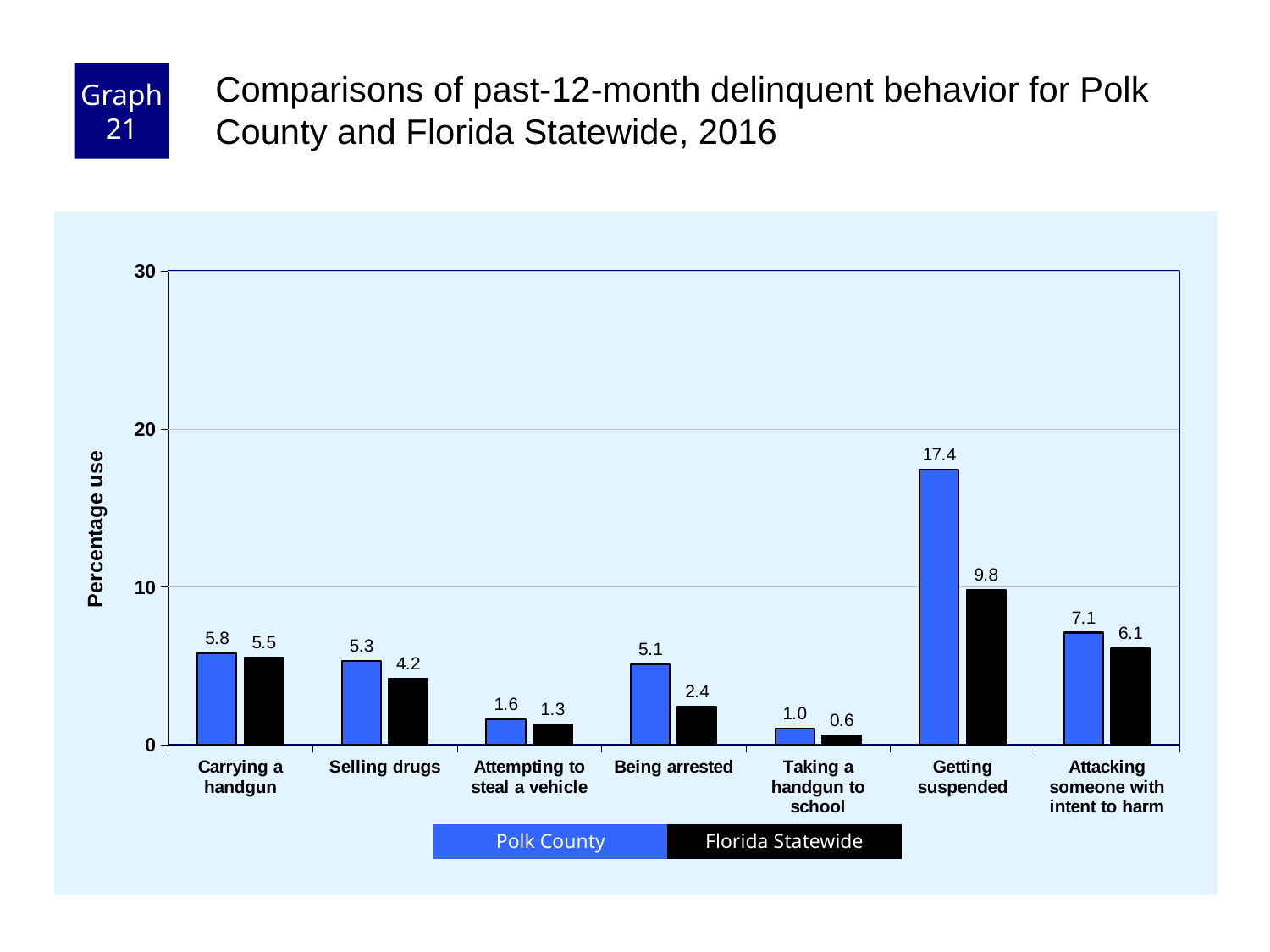
How many series does the legend list? 2 What is the difference between the Polk County and Florida Statewide values for Getting suspended? 7.6 What kind of chart is shown on the slide? bar chart What is the Polk County value for Taking a handgun to school? 1.0 Which category has the highest Florida Statewide value? Getting suspended Which category has the lowest Polk County value? Taking a handgun to school Is the Polk County value for Getting suspended greater or less than 20? less What is the label of the y axis? Percentage use How many categories are shown on the x axis? 7 Which is larger for Selling drugs: the Polk County value or the Florida Statewide value? Polk County What is the Florida Statewide value for Being arrested? 2.4 What is the Polk County value for Getting suspended? 17.4